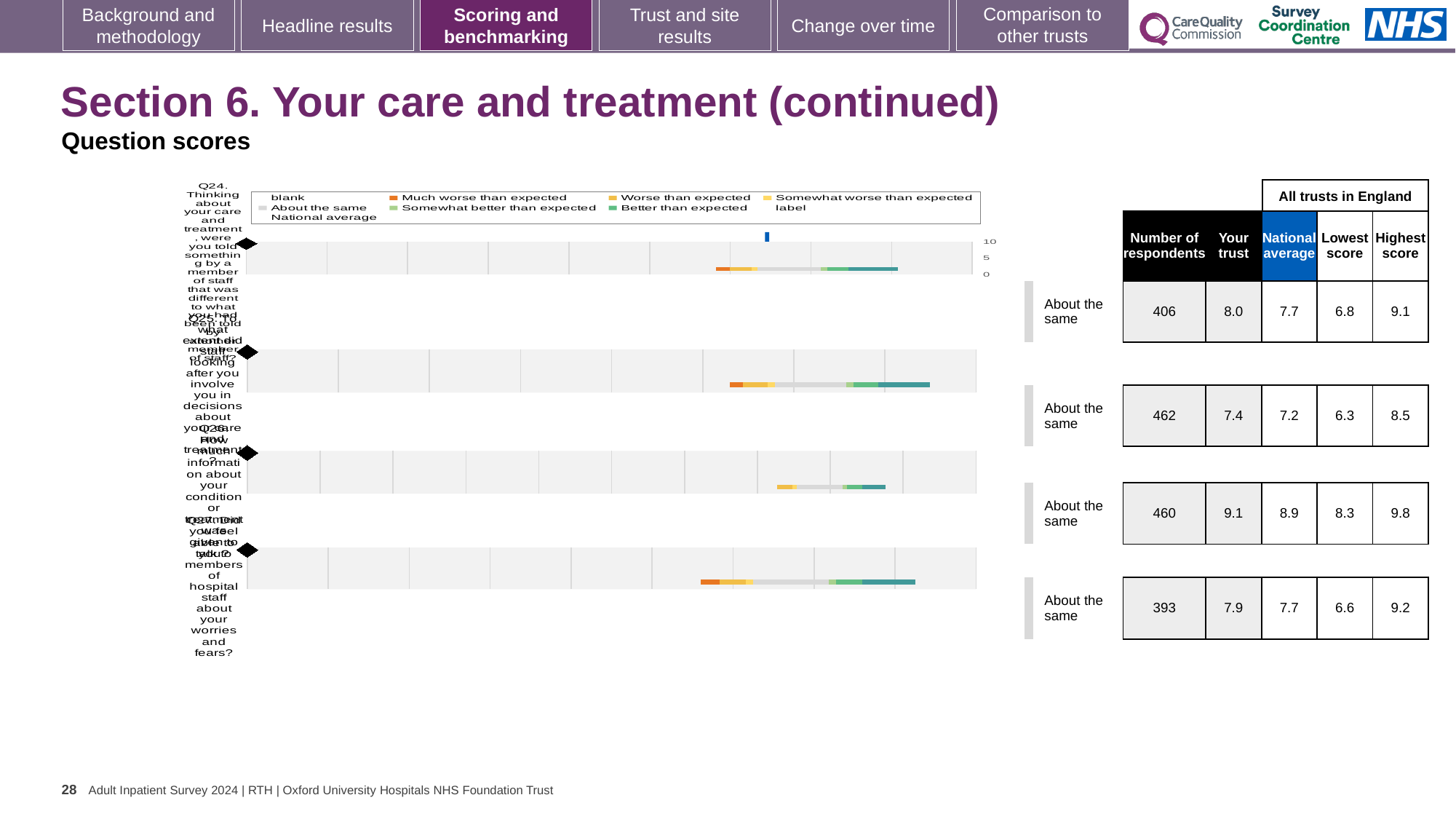
In the table next to the top chart (Q24), what is the 'Your trust' score? 8.0 How many entries does the legend above the top chart list? 9 In the table next to the third chart from the top, how many respondents are listed? 460 Which of the four charts on the slide has the highest 'Your trust' score in its table? The third chart from the top (9.1) How many benchmark charts are shown on the slide? 4 For the top chart (Q24), what is the difference between the 'Your trust' score and the national average? 0.3 Which of the four charts on the slide has the lowest 'Your trust' score in its table? The second chart from the top (7.4) For the bottom chart, which is larger: the 'Your trust' score or the national average? Your trust (7.9) In the table next to the bottom chart, what is the highest score among all trusts in England? 9.2 What benchmark category is shown beside each of the four charts? About the same What kind of chart is used for each question on the slide? Bar chart In the table next to the second chart from the top, what is the national average score? 7.2